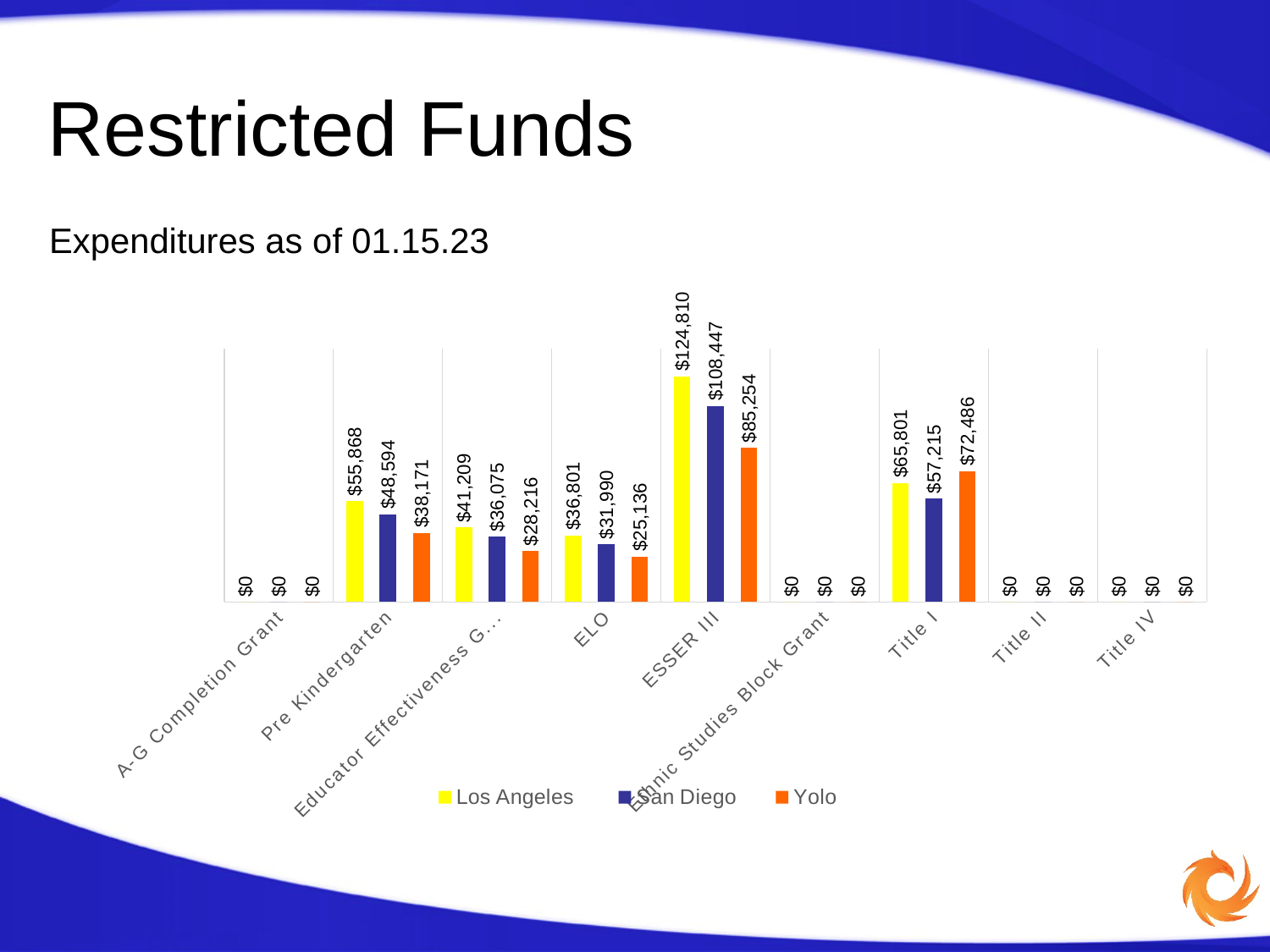
What is the San Diego expenditure for Pre Kindergarten? $48,594 What is the Yolo expenditure for ELO? $25,136 How many series does the legend list? 3 What is the difference between the Yolo and Los Angeles expenditures for Title I? $6,685 How many categories are shown on the x axis of the chart? 9 Which category has the highest Yolo expenditure? ESSER III What is the Yolo expenditure for Title I? $72,486 Which category has the highest Los Angeles expenditure? ESSER III For Title I, which is larger: the Los Angeles expenditure or the Yolo expenditure? Yolo What is the difference between the Los Angeles and San Diego expenditures for ESSER III? $16,363 What is the Los Angeles expenditure for ESSER III? $124,810 What kind of chart is shown on the slide? Bar chart